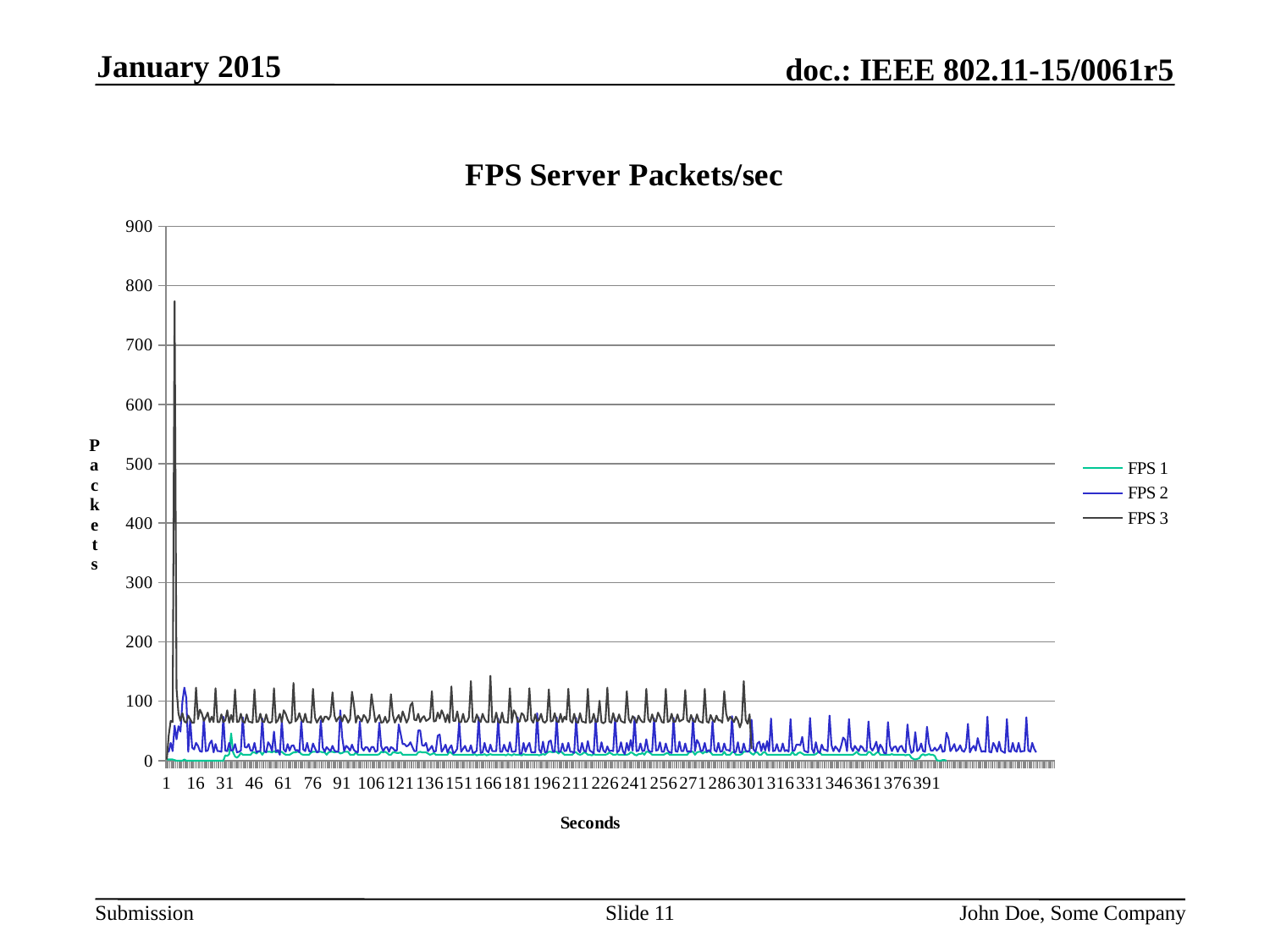
Which series reaches the highest peak value on the chart? FPS 3 What is the title of the chart? FPS Server Packets/sec Is the highest value of FPS 1 greater or less than 100? less Is the highest value of FPS 2 greater or less than 200? less What is the label of the x axis? Seconds Which series has larger values for most of the chart, FPS 2 or FPS 1? FPS 2 Which series has the lowest values overall on the chart? FPS 1 Is the highest peak of FPS 3 greater or less than 700? greater What kind of chart is shown on the slide? line chart How many series does the legend list? 3 What is the highest value shown on the y axis? 900